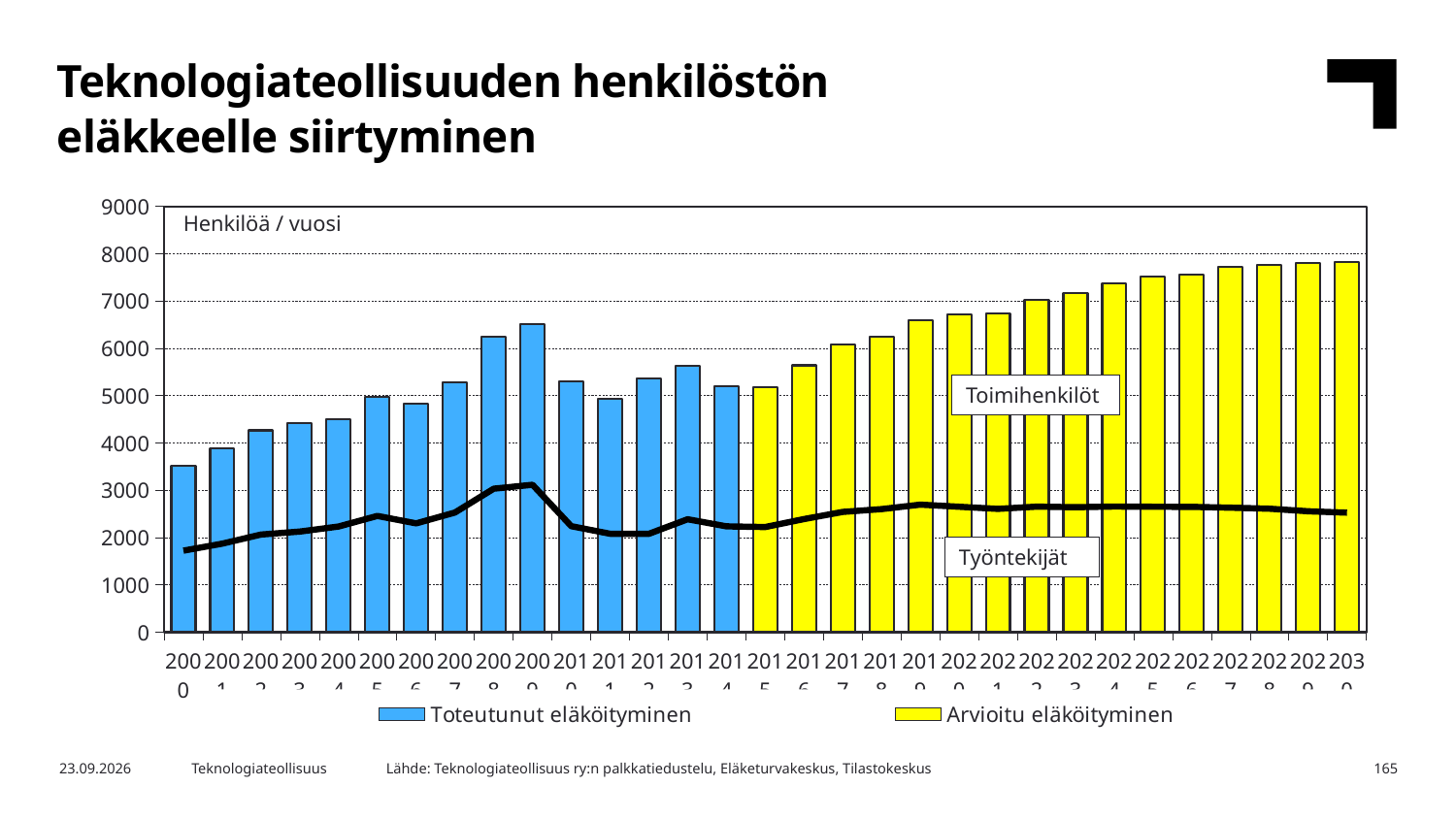
Which year has the lowest bar? 2000 What are the two legend entries? Toteutunut eläköityminen, Arvioitu eläköityminen Is the bar for 2030 greater or less than 8000? less Is the bar for 2009 greater or less than 6000? greater Is the bar for 2020 greater or less than 6000? greater What unit label is shown inside the plot area at the top left? Henkilöä / vuosi How many years (bars) are plotted on the x axis? 31 Which bar is taller, 2009 or 2010? 2009 How many series does the legend list? 2 Do the yellow (Arvioitu eläköityminen) bars generally rise or fall from 2015 to 2030? rise What kind of chart is shown on the slide? Bar chart with a line